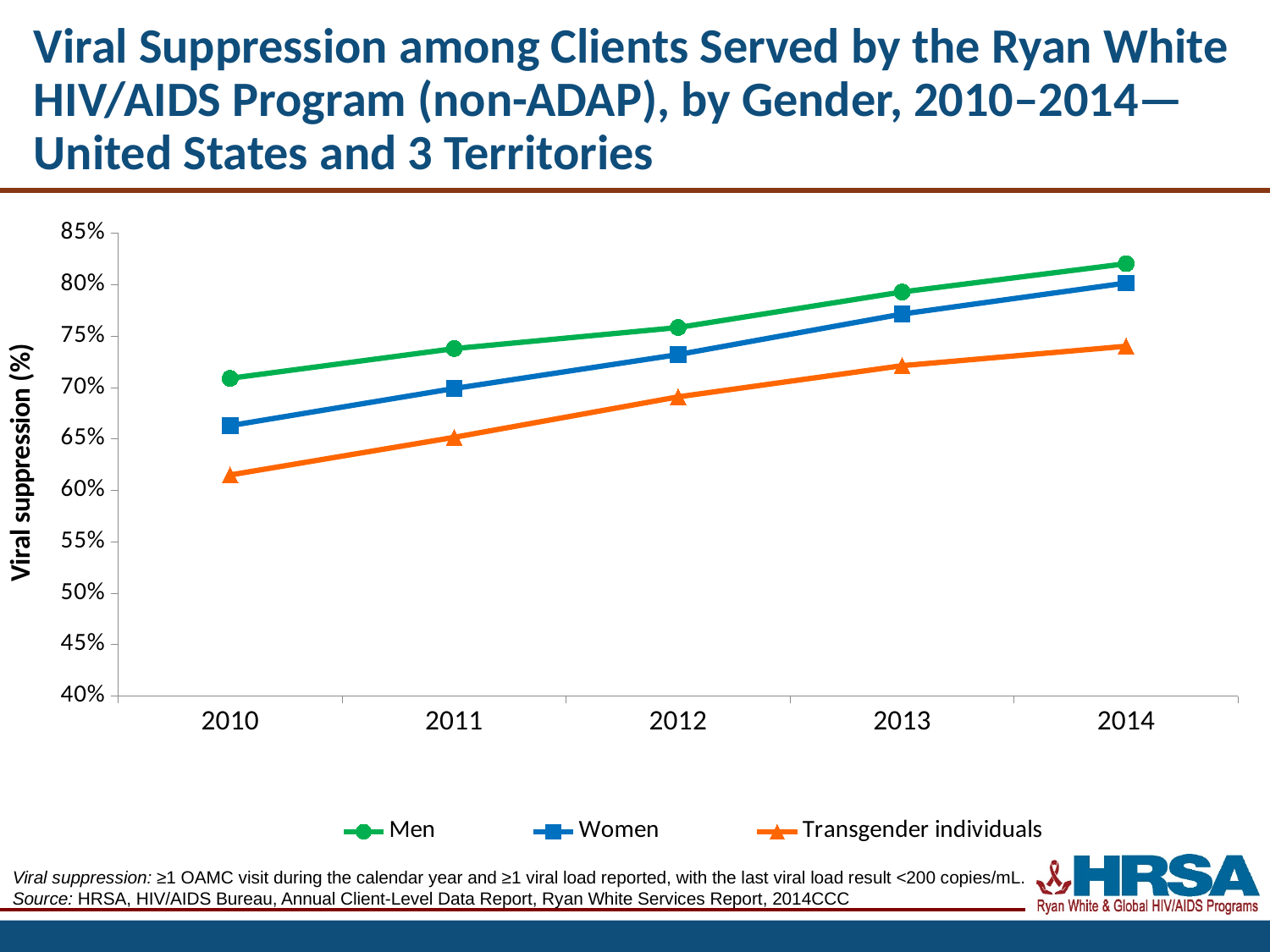
Is the value for Women in 2010 greater or less than 70%? less Is the value for Transgender individuals in 2014 greater or less than 75%? less Is the value for Men in 2014 greater or less than 80%? greater Which group has the highest viral suppression in 2014? Men What is the label on the y axis? Viral suppression (%) In 2012, which is higher: viral suppression for Men or for Women? Men How many series does the legend list? 3 What kind of chart is shown on the slide? Line chart Does viral suppression for Transgender individuals rise or fall from 2010 to 2014? Rise How many years are plotted along the x axis? 5 Which group has the lowest viral suppression in 2010? Transgender individuals